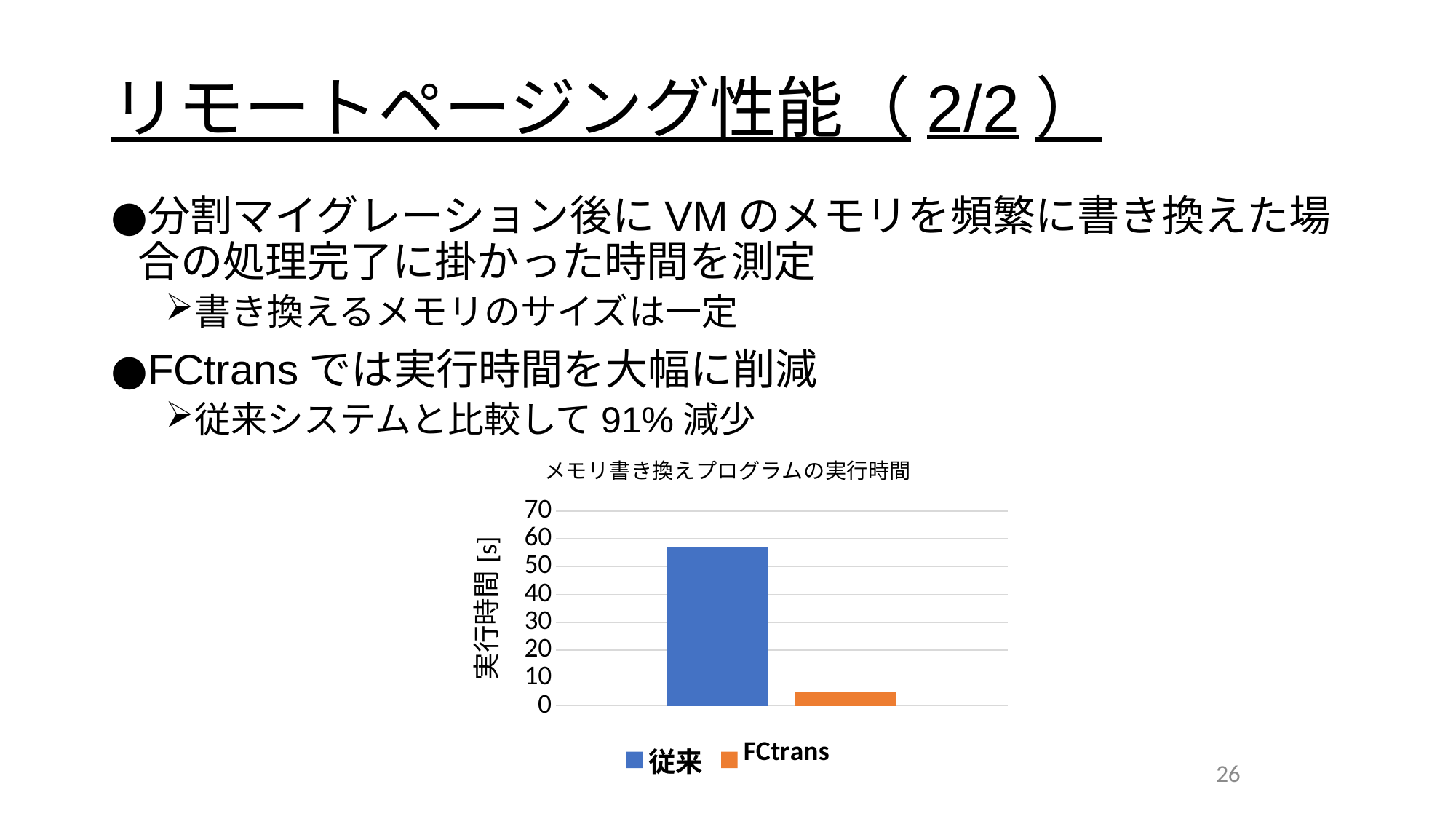
Which series has the highest execution time in the chart? 従来 Which has a larger execution time, 従来 or FCtrans? 従来 What is the label of the vertical axis of the chart? 実行時間 [s] Is the value for FCtrans greater or less than 10? less Is the value for 従来 greater or less than 60? less Is the value for 従来 greater or less than 50? greater How many bars are plotted in the chart? 2 What kind of chart is shown on the slide? bar chart What is the title of the chart? メモリ書き換えプログラムの実行時間 How many series does the chart legend list? 2 Which series has the lowest execution time in the chart? FCtrans